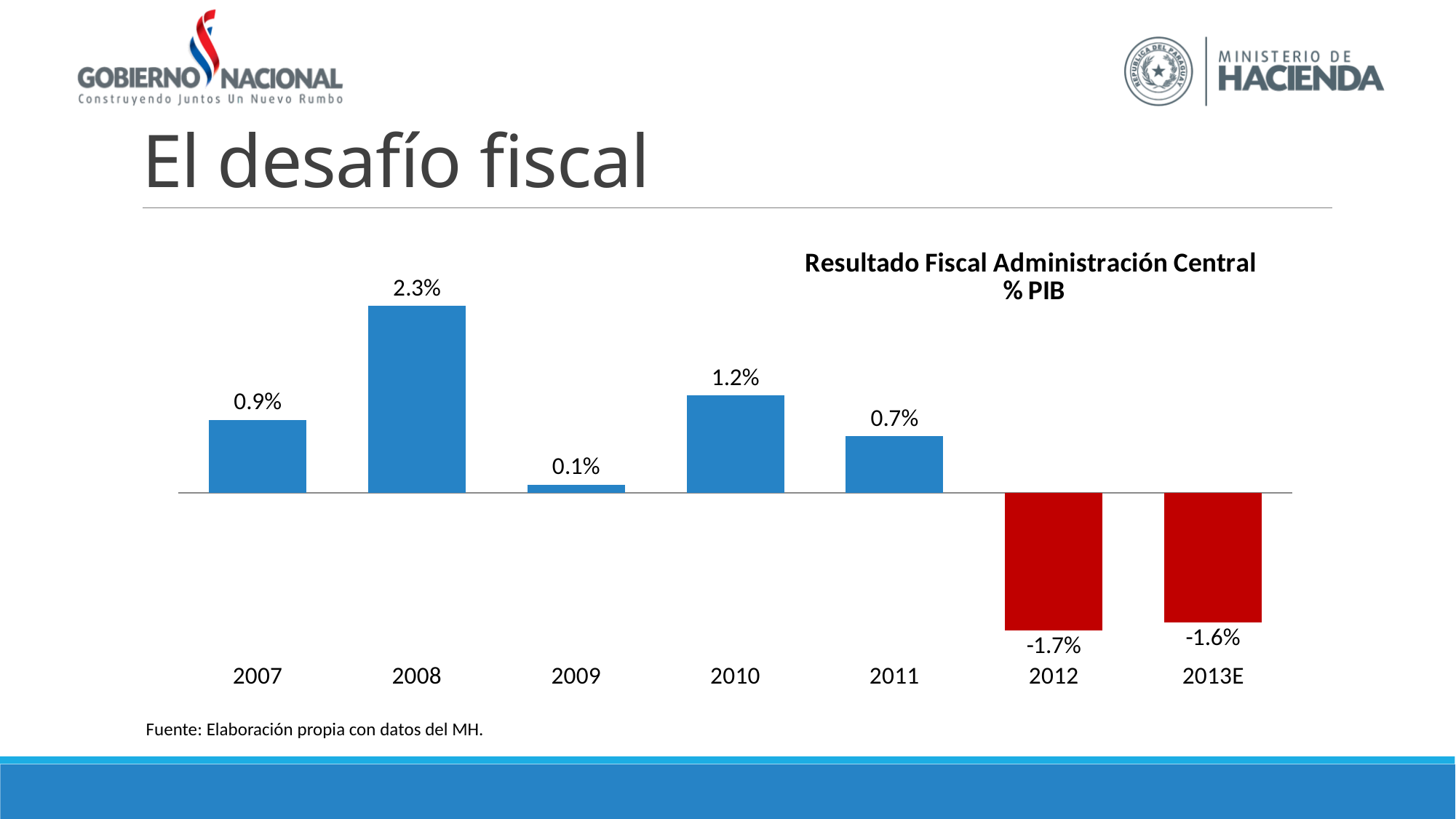
What is the value for 2008? 2.3% What is the value for 2013E? -1.6% Which year has the lowest value? 2012 What is the value for 2009? 0.1% How many years are shown on the chart? 7 What is the difference between the values for 2008 and 2010? 1.1% Which year has the highest value? 2008 What is the title of the chart? Resultado Fiscal Administración Central % PIB Do the values rise or fall from 2010 to 2012? fall What kind of chart is shown on the slide? bar chart What is the value for 2012? -1.7% Which is larger, the value for 2007 or the value for 2011? 2007